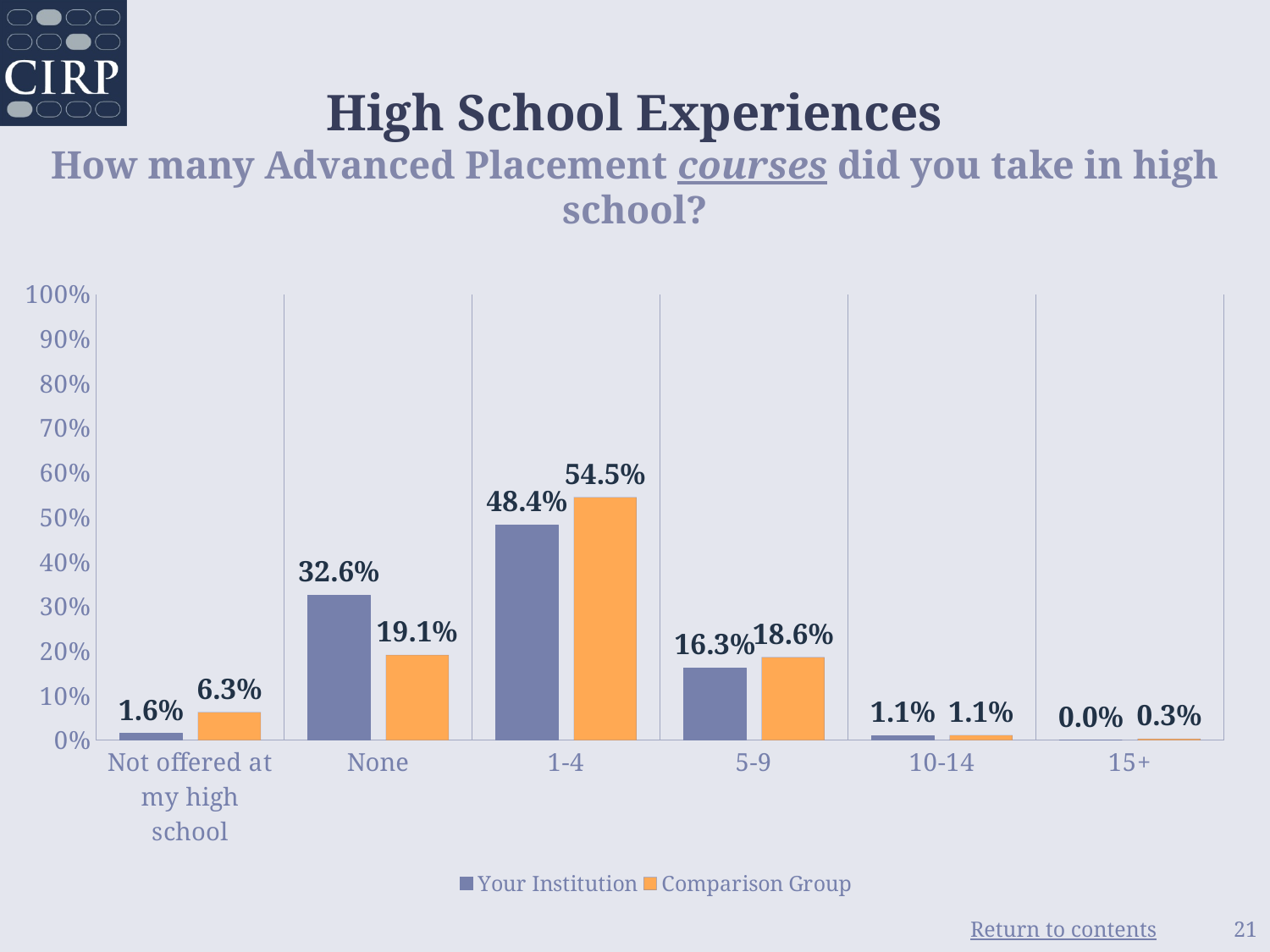
What percentage of Your Institution respondents took 1-4 Advanced Placement courses? 48.4% How many categories are shown on the x axis? 6 What kind of chart is shown on the slide? Bar chart Which category has the highest value for the Comparison Group? 1-4 What is the Comparison Group value for the 'None' category? 19.1% What is the difference between the Your Institution and Comparison Group values for the 'None' category? 13.5% Is the Comparison Group value for 1-4 greater or less than 50%? greater What is the Your Institution value for 'Not offered at my high school'? 1.6% For the 5-9 category, which series has the larger value, Your Institution or Comparison Group? Comparison Group Which category has the lowest value for Your Institution? 15+ What colour are the Comparison Group bars? Orange How many series does the legend list? 2